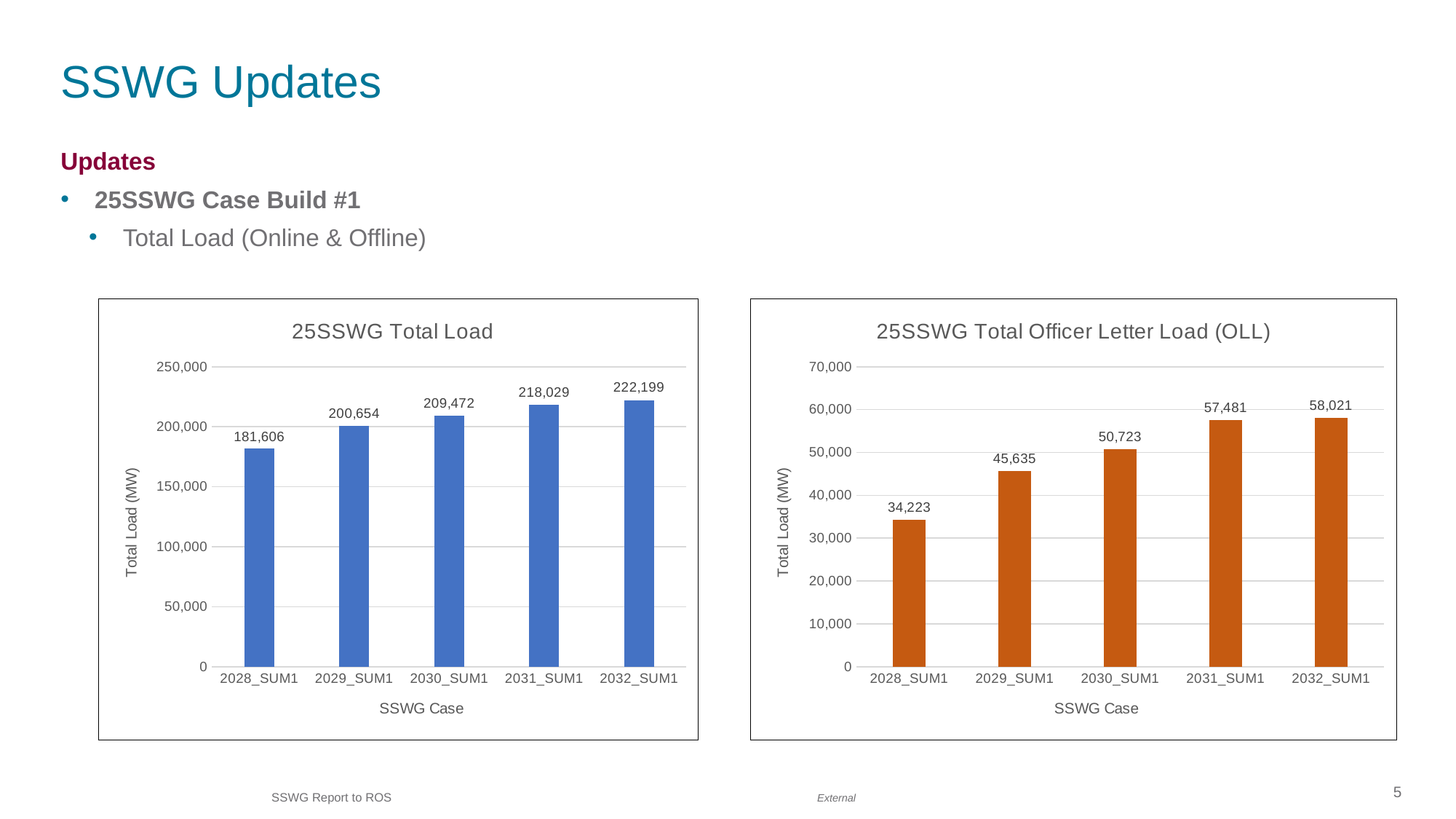
In the 25SSWG Total Officer Letter Load (OLL) chart, what is the value for 2032_SUM1? 58,021 How many SSWG cases are shown in the 25SSWG Total Officer Letter Load (OLL) chart? 5 In the 25SSWG Total Officer Letter Load (OLL) chart, what is the difference between the values for 2030_SUM1 and 2029_SUM1? 5,088 In the 25SSWG Total Officer Letter Load (OLL) chart, what is the value for 2029_SUM1? 45,635 In the 25SSWG Total Load chart, which SSWG case has the highest total load? 2032_SUM1 In the 25SSWG Total Load chart, is the value for 2029_SUM1 greater or less than 150,000? greater In the 25SSWG Total Load chart, what is the difference between the values for 2032_SUM1 and 2028_SUM1? 40,593 In the 25SSWG Total Load chart, what is the value for 2030_SUM1? 209,472 In the 25SSWG Total Officer Letter Load (OLL) chart, do the values rise or fall from 2028_SUM1 to 2032_SUM1? Rise What kind of chart is the 25SSWG Total Load chart? Bar chart In the 25SSWG Total Officer Letter Load (OLL) chart, which SSWG case has the lowest value? 2028_SUM1 In the 25SSWG Total Load chart, what is the value for 2028_SUM1? 181,606